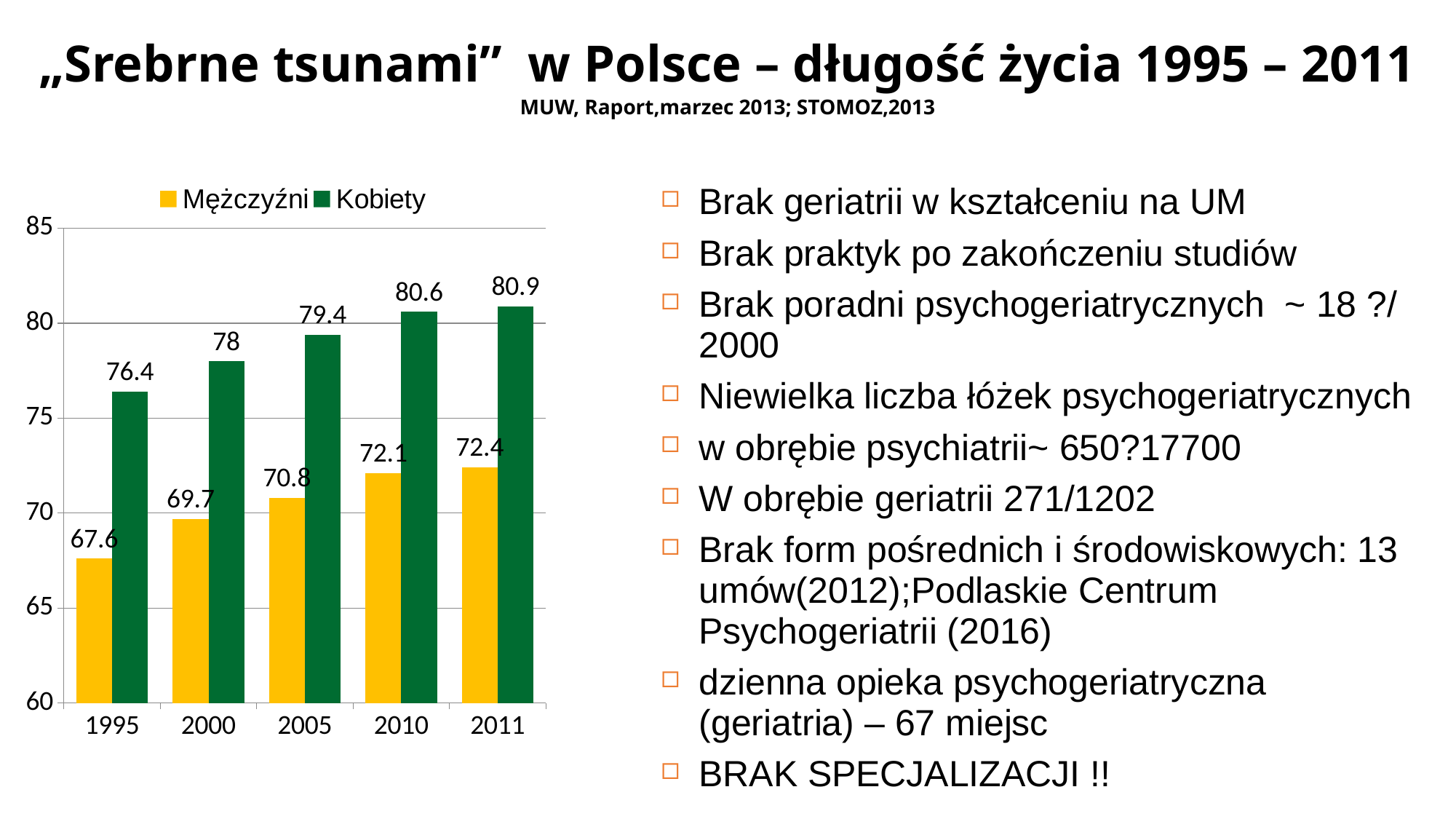
What is the value for Kobiety in 2011? 80.9 Which is larger in 2000: the Mężczyźni value or the Kobiety value? Kobiety Do the Mężczyźni values rise or fall from 1995 to 2011? rise Is the value for Kobiety in 2000 greater or less than 75? greater What is the value for Kobiety in 2005? 79.4 In which year is the Kobiety value lowest? 1995 In which year is the Mężczyźni value highest? 2011 What kind of chart is shown on the slide? bar chart What is the value for Mężczyźni in 1995? 67.6 What is the difference between the Kobiety and Mężczyźni values in 2010? 8.5 How many series does the legend list? 2 How many years are shown on the x axis? 5